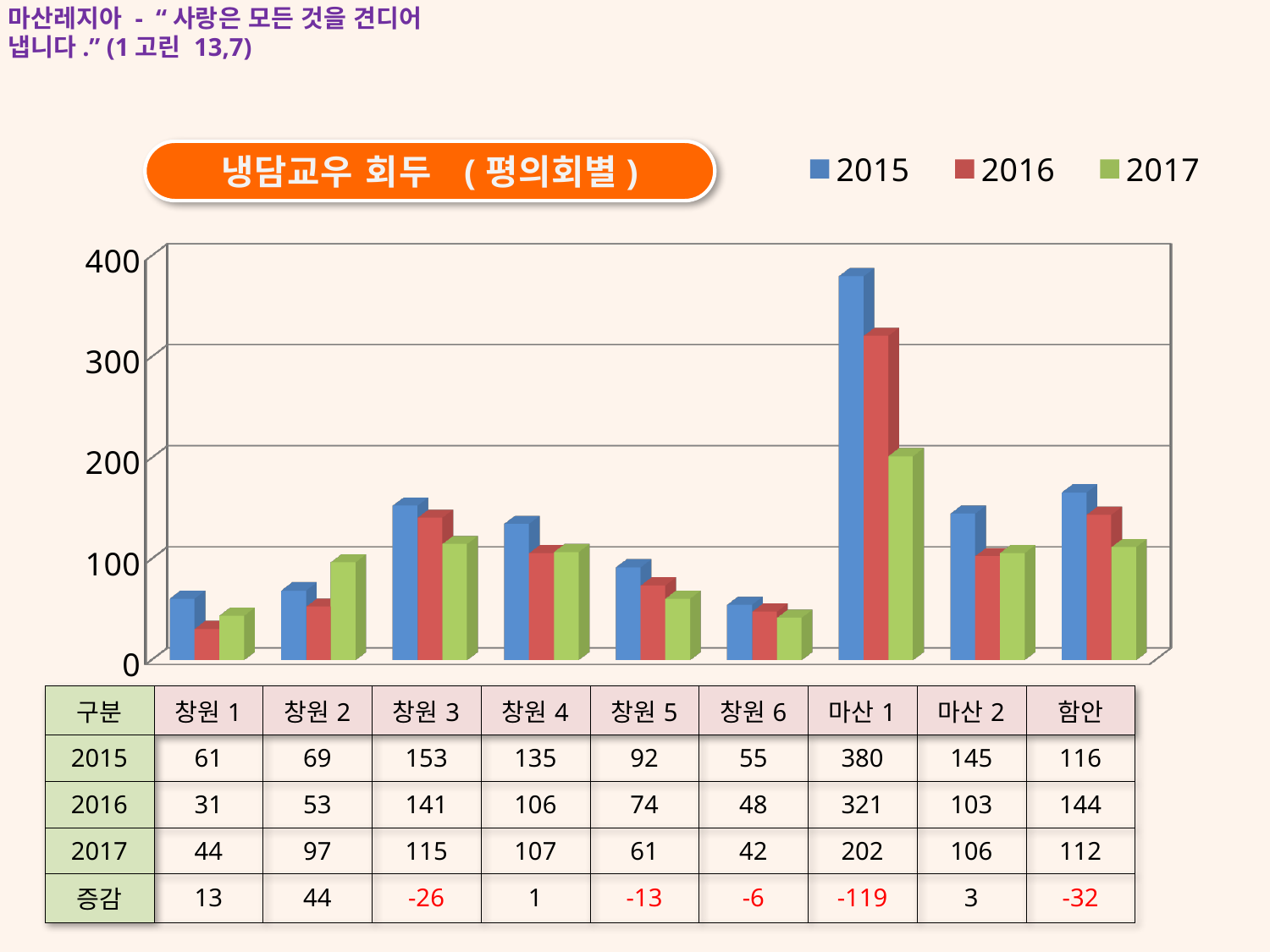
Which category has the lowest 2016 value? 창원 1 What is the 2017 value for 창원 2? 97 What is the 2015 value for 마산 1? 380 Which is larger for 창원 3: the 2016 value or the 2017 value? 2016 What is the difference between the 2015 and 2017 values for 마산 1? 178 Which colour represents the 2017 series in the chart? green Which category has the highest 2015 value? 마산 1 Is the 2015 value for 창원 4 greater or less than 100? greater How many series does the legend list? 3 What type of chart is shown on the slide? bar chart How many categories are plotted along the x axis? 9 What is the 2016 value for 함안? 144